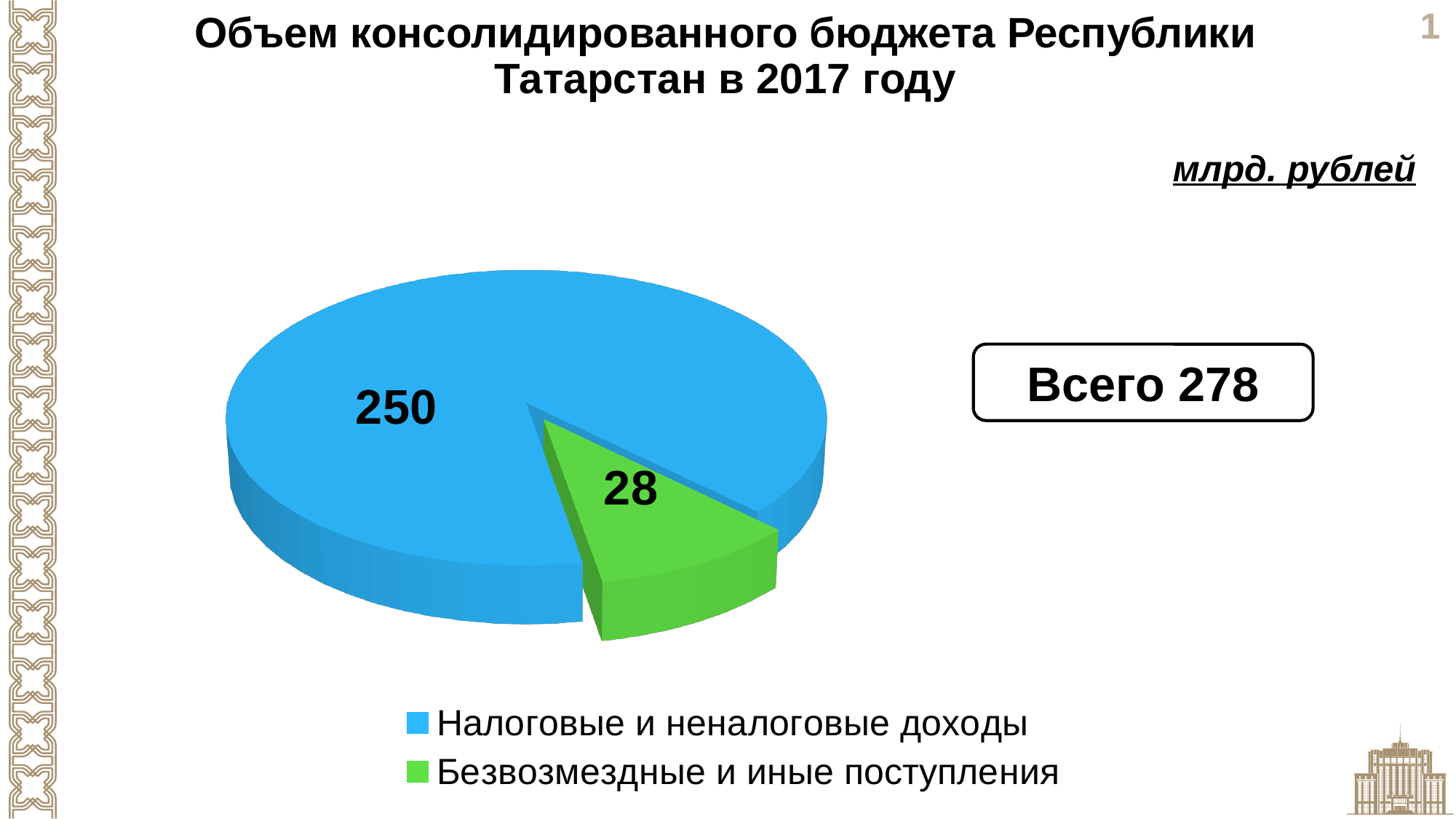
How many entries does the legend list? 2 What kind of chart is shown on the slide? Pie chart What is the total of all slices in the pie chart? 278 What colour is the slice for Безвозмездные и иные поступления? Green Which is larger: Налоговые и неналоговые доходы or Безвозмездные и иные поступления? Налоговые и неналоговые доходы What is the difference between the values for Налоговые и неналоговые доходы and Безвозмездные и иные поступления? 222 Which category has the smallest slice of the pie? Безвозмездные и иные поступления What unit of measurement is indicated on the slide? млрд. рублей What is the value for Безвозмездные и иные поступления? 28 How many slices does the pie chart have? 2 Which category has the largest slice of the pie? Налоговые и неналоговые доходы What is the value for Налоговые и неналоговые доходы? 250